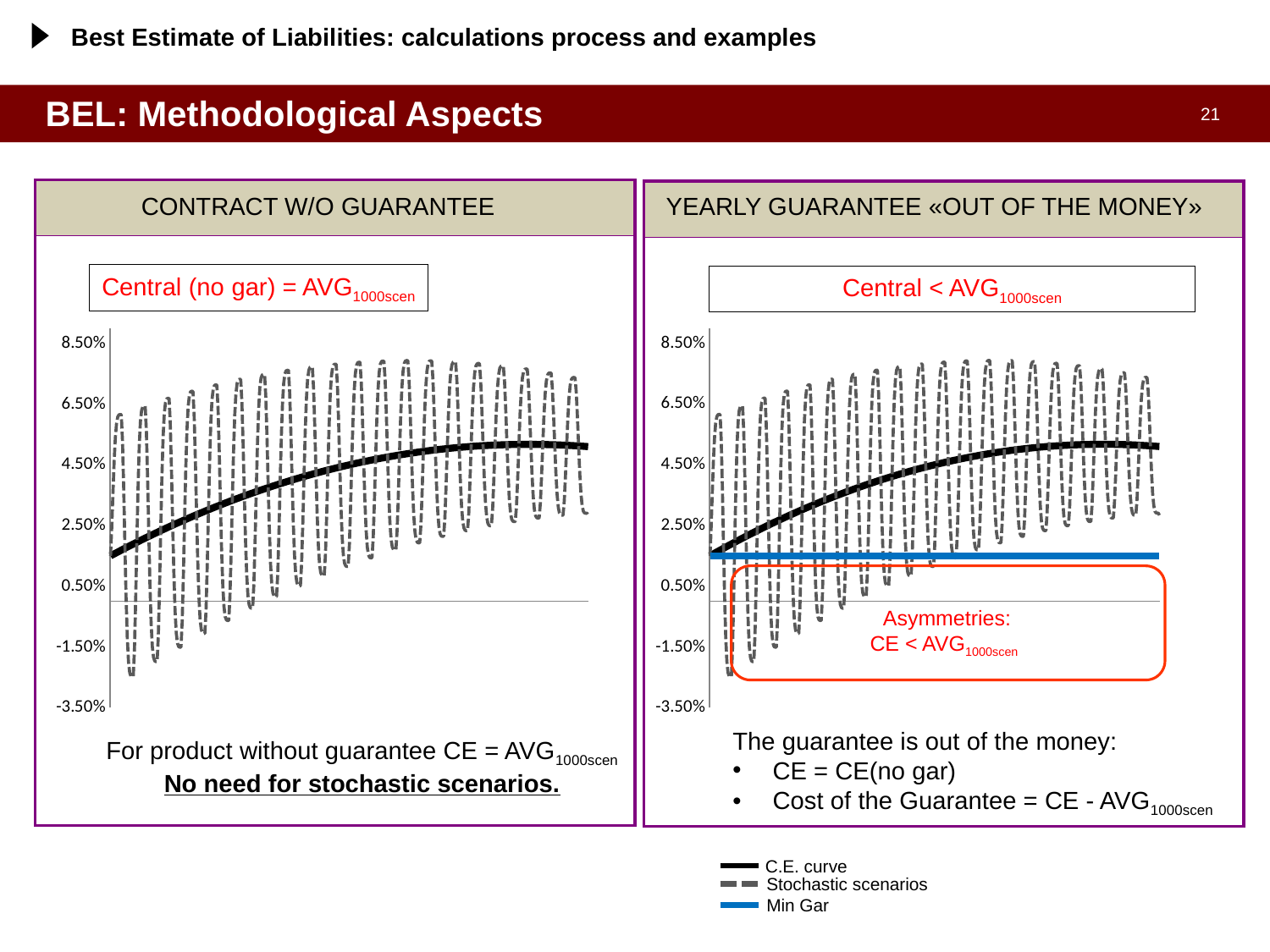
In the right chart (YEARLY GUARANTEE «OUT OF THE MONEY»), is the Min Gar line greater or less than 2.50%? less In the left chart (CONTRACT W/O GUARANTEE), is the value of the C.E. curve at the right end of the x axis greater or less than 4.50%? greater In the right chart (YEARLY GUARANTEE «OUT OF THE MONEY»), is the Min Gar line greater or less than 0.50%? greater What is the highest value shown on the y axis of the left chart (CONTRACT W/O GUARANTEE)? 8.50% According to the legend, what colour is the Min Gar line? Blue How many series does the legend at the bottom of the slide list? 3 What kind of chart is shown in the right panel titled "YEARLY GUARANTEE «OUT OF THE MONEY»"? Line chart What kind of chart is shown in the left panel titled "CONTRACT W/O GUARANTEE"? Line chart In the right chart (YEARLY GUARANTEE «OUT OF THE MONEY»), does the C.E. curve rise or fall along the x axis? Rise In the left chart (CONTRACT W/O GUARANTEE), does the C.E. curve rise or fall along the x axis? Rise